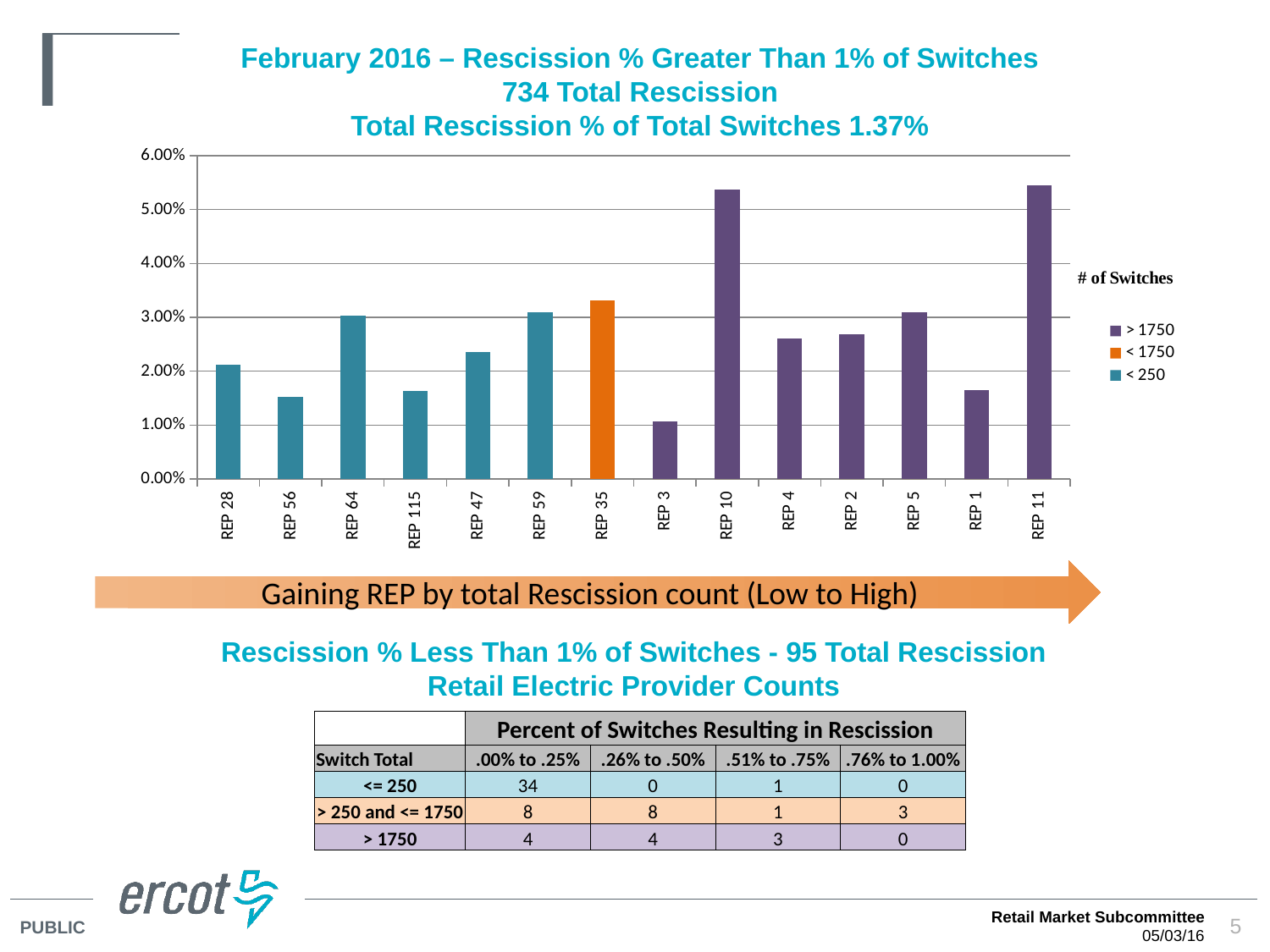
What kind of chart is shown on the slide? bar chart Which has a higher rescission percentage, REP 35 or REP 4? REP 35 What is the title of the chart legend? # of Switches Is the value for REP 11 greater or less than 5.00%? greater How many series does the chart legend list? 3 Is the value for REP 10 greater or less than 5.00%? greater Is the value for REP 4 greater or less than 3.00%? less Which REP has the lowest rescission percentage on the chart? REP 3 How many REP categories are plotted on the chart? 14 Which has a higher rescission percentage, REP 64 or REP 56? REP 64